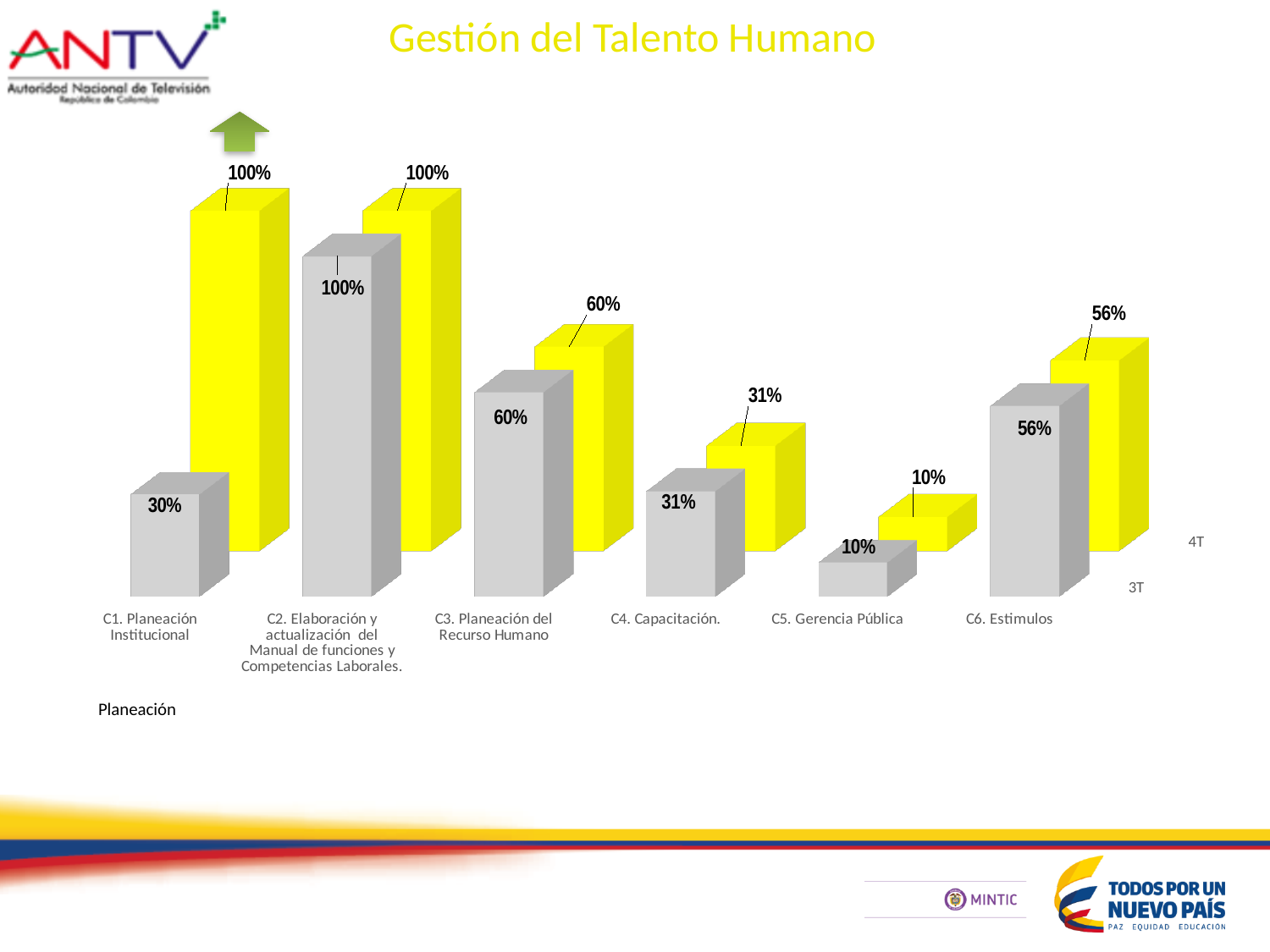
What is the 4T value for C1. Planeación Institucional? 100% Which is larger for C1. Planeación Institucional, the 3T value or the 4T value? 4T What is the 3T value for C3. Planeación del Recurso Humano? 60% What is the 3T value for C1. Planeación Institucional? 30% Which category has the lowest 4T value? C5. Gerencia Pública How many categories are shown on the x axis? 6 Which category has the lowest 3T value? C5. Gerencia Pública What is the difference between the 4T and 3T values for C1. Planeación Institucional? 70% What is the 4T value for C4. Capacitación? 31% How many series does the chart show? 2 What is the title of the chart? Gestión del Talento Humano What is the 4T value for C6. Estimulos? 56%